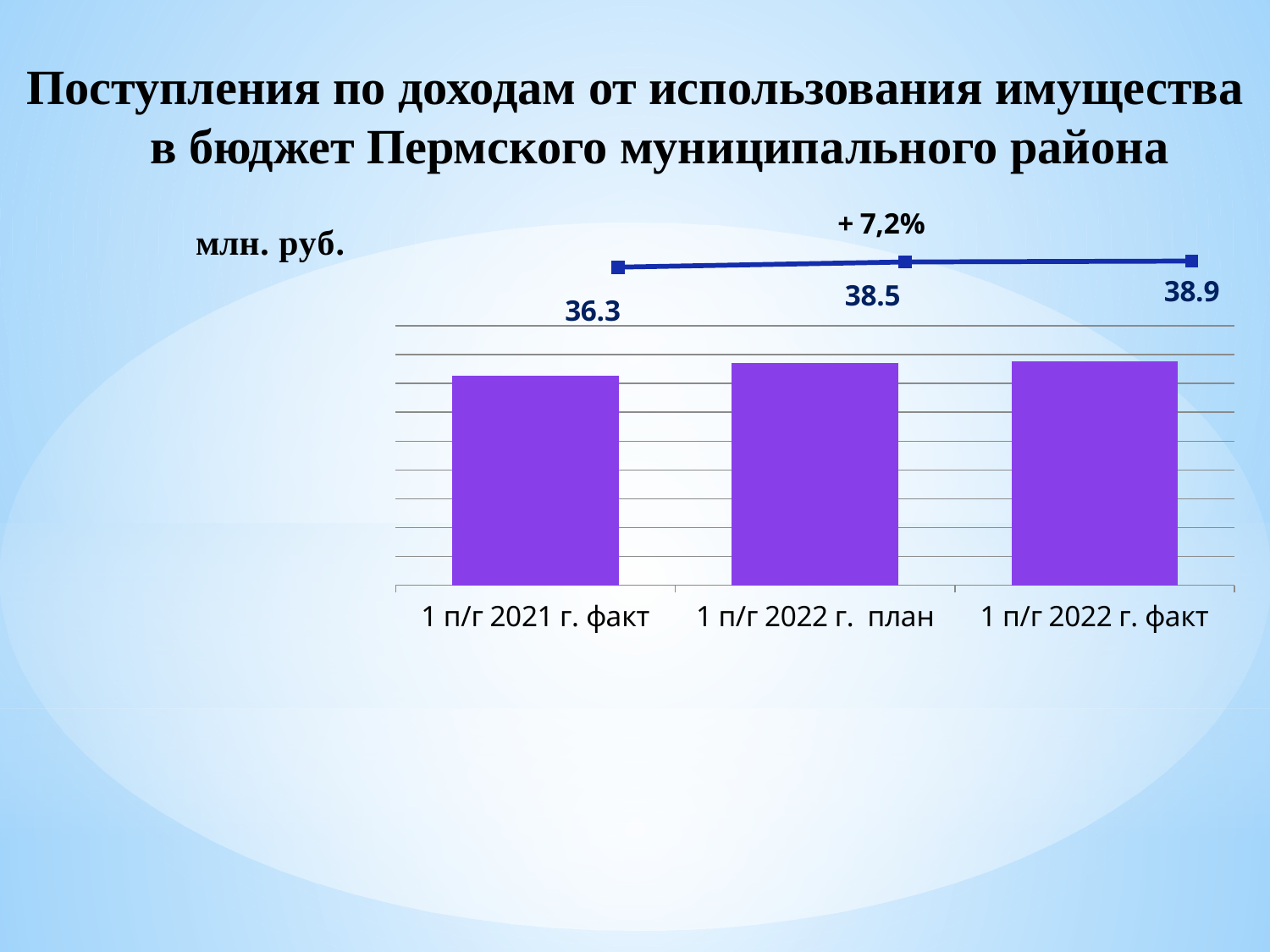
How many categories are shown in the chart? 3 What is the value for 1 п/г 2021 г. факт? 36.3 Do the values rise or fall from left to right along the x axis? Rise What kind of chart is shown on the slide? Bar chart What is the difference between the values for 1 п/г 2022 г. факт and 1 п/г 2022 г. план? 0.4 Which category has the lowest value? 1 п/г 2021 г. факт What is the difference between the values for 1 п/г 2022 г. факт and 1 п/г 2021 г. факт? 2.6 What unit of measurement is indicated for the chart values? млн. руб. What is the value for 1 п/г 2022 г. факт? 38.9 What is the value for 1 п/г 2022 г. план? 38.5 Which is larger, the value for 1 п/г 2022 г. план or the value for 1 п/г 2021 г. факт? 1 п/г 2022 г. план Which category has the highest value? 1 п/г 2022 г. факт